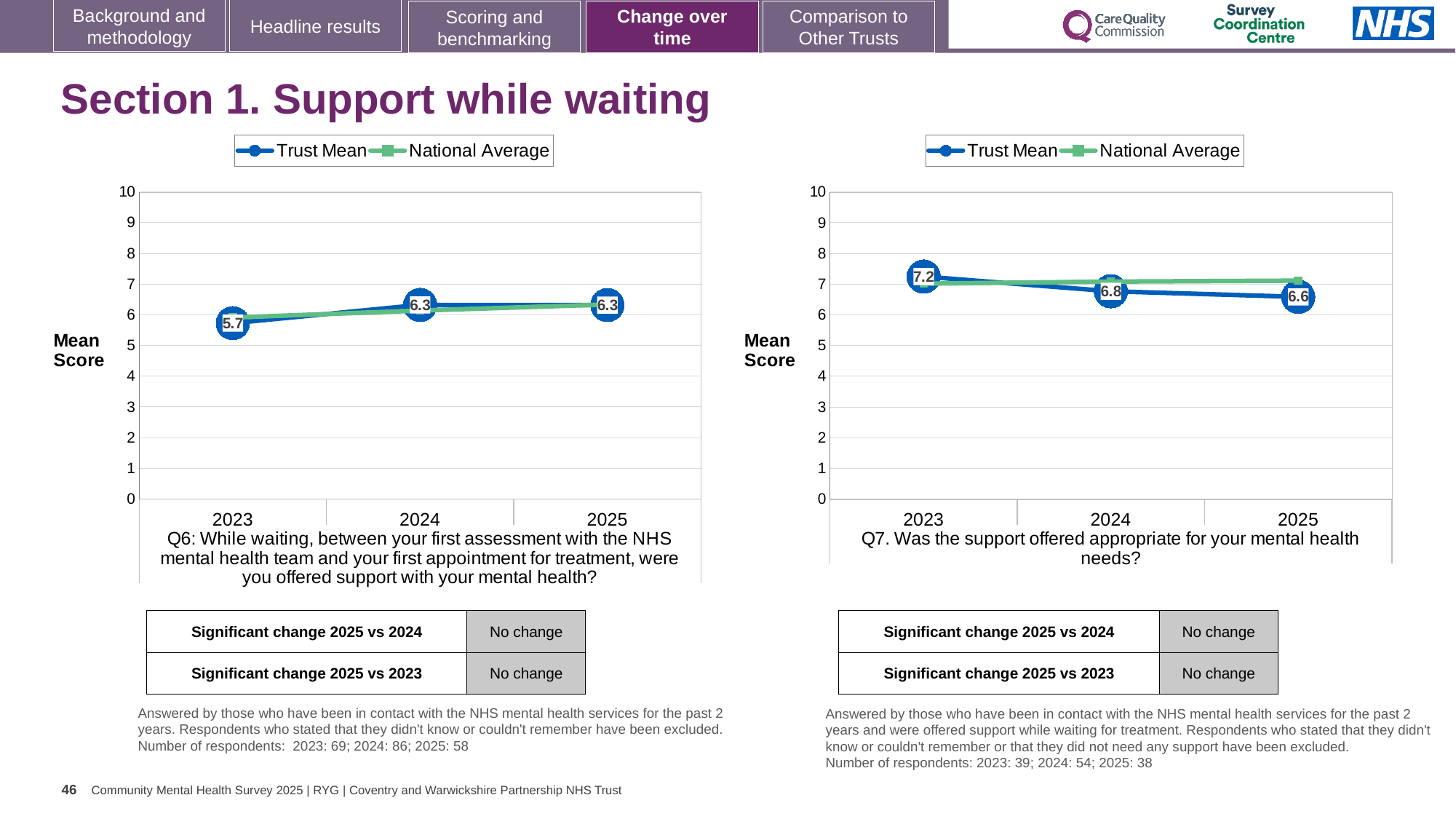
On the right chart (Q7), what is the difference between the Trust Mean scores for 2023 and 2025? 0.6 On the left chart (Q6), is the Trust Mean score for 2023 greater or less than 6? less On the left chart (Q6), in which year is the Trust Mean score lowest? 2023 How many series does the legend of the right chart (Q7) list? 2 On the left chart (Q6), what is the Trust Mean score for 2025? 6.3 On the right chart (Q7), in which year is the Trust Mean score highest? 2023 On the right chart (Q7), what is the Trust Mean score for 2023? 7.2 On the right chart (Q7), what is the Trust Mean score for 2025? 6.6 On the right chart (Q7), does the Trust Mean score rise or fall from 2023 to 2025? fall What kind of chart is the left chart (Q6)? line chart On the left chart (Q6), what is the difference between the Trust Mean scores for 2024 and 2023? 0.6 On the left chart (Q6), what is the Trust Mean score for 2023? 5.7